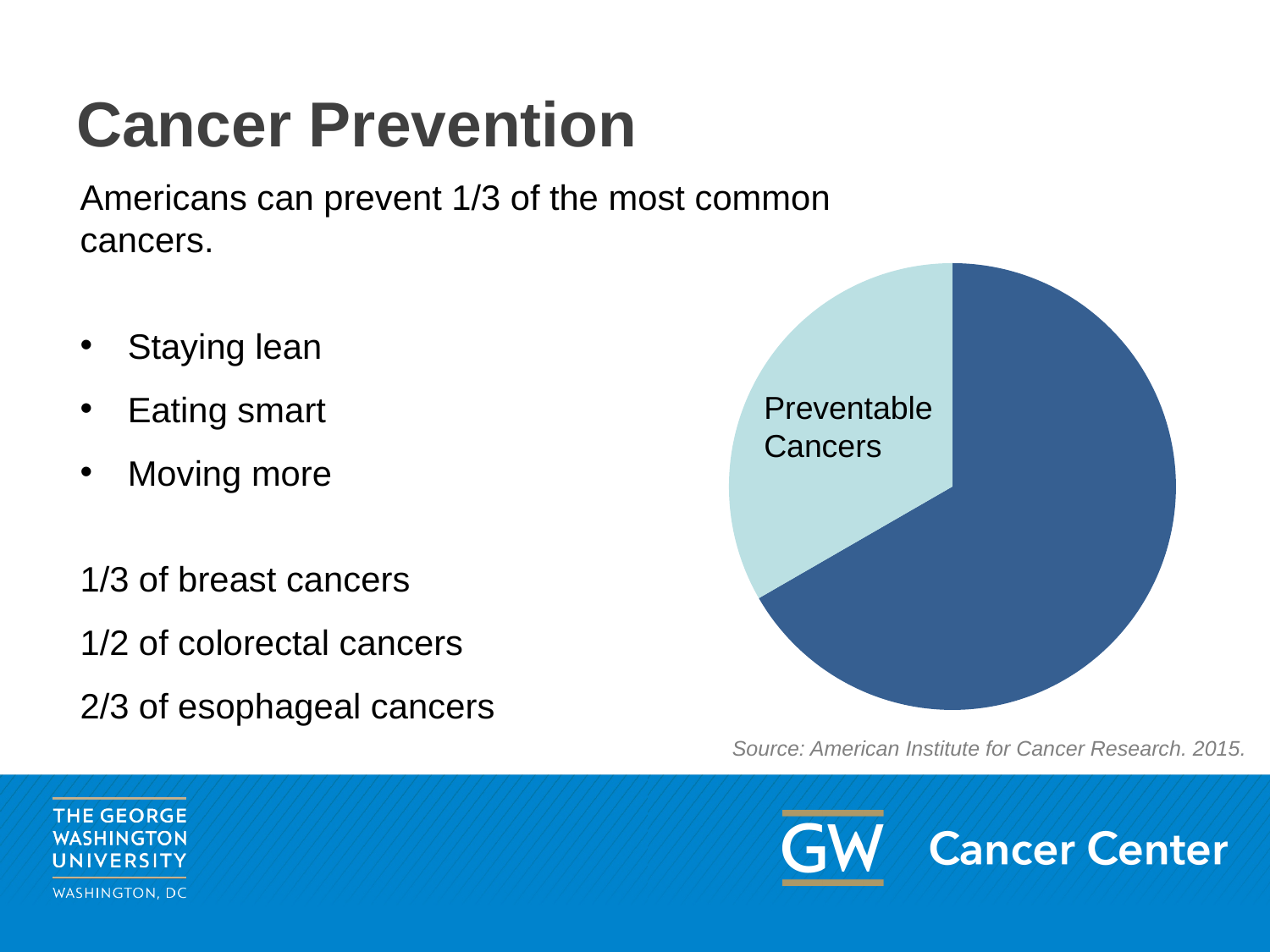
What kind of chart is shown on the slide? pie chart Does the pie chart include a legend? No Is the Preventable Cancers slice the larger or the smaller slice of the pie chart? smaller Is the Preventable Cancers slice greater or less than half of the pie? less Is the unlabelled dark blue slice greater or less than half of the pie? greater Which slice of the pie chart is labelled? Preventable Cancers What colour is the Preventable Cancers slice of the pie chart? light blue How many slices does the pie chart have? 2